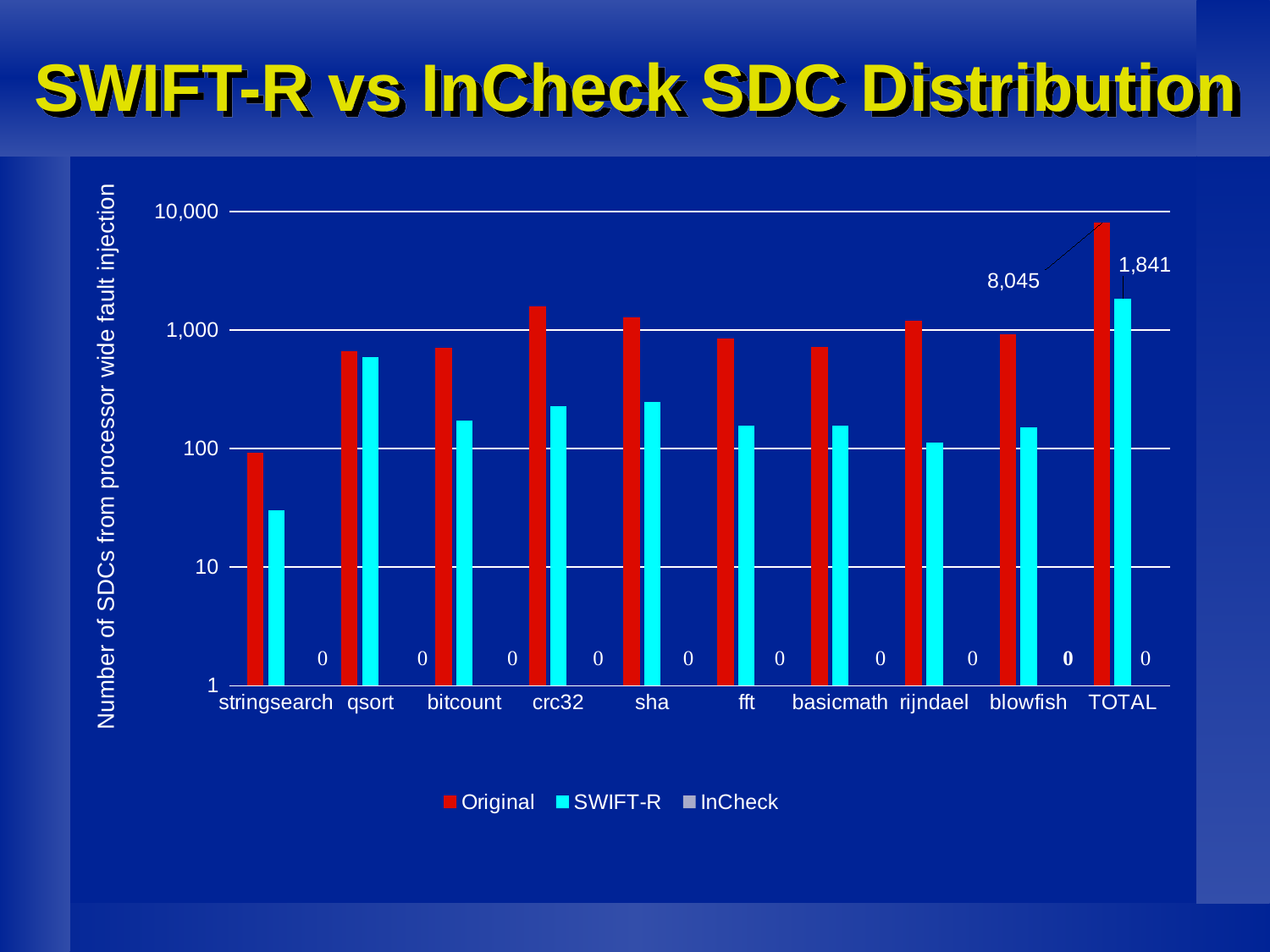
Is the SWIFT-R value for stringsearch greater or less than 100? less Which category has the lowest SWIFT-R value? stringsearch How many categories are shown on the x axis? 10 What kind of chart is shown on the slide? Bar chart Is the Original value for crc32 greater or less than 1,000? greater Which category has the highest Original value? TOTAL For sha, which is larger: the Original value or the SWIFT-R value? Original What is the difference between the Original and SWIFT-R values for TOTAL? 6,204 What is the Original value for TOTAL? 8,045 What is the InCheck value for crc32? 0 How many series does the legend list? 3 What is the SWIFT-R value for TOTAL? 1,841